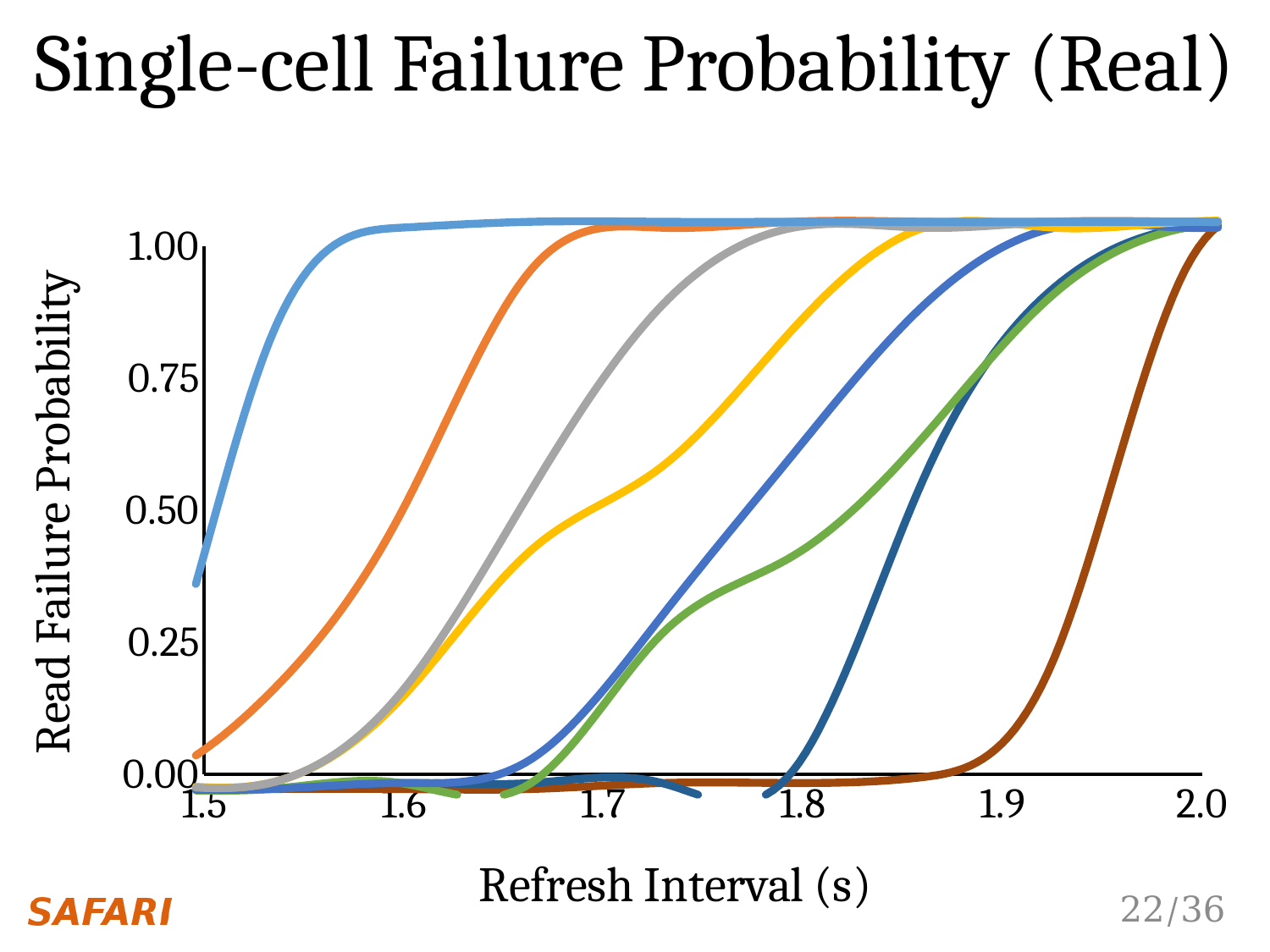
Is the value of the brown line at a refresh interval of 1.8 s greater or less than 0.25? less How many lines are plotted on the chart? 8 What is the label of the x axis? Refresh Interval (s) Is the value of the orange line at a refresh interval of 1.7 s greater or less than 0.75? greater At a refresh interval of 1.7 s, which line has the higher read failure probability, the orange line or the brown line? orange line Is the value of the yellow line at a refresh interval of 1.6 s greater or less than 0.25? less What kind of chart is shown on the slide? line chart What is the title of the chart? Single-cell Failure Probability (Real) Do the plotted lines rise or fall as the refresh interval increases along the x axis? rise